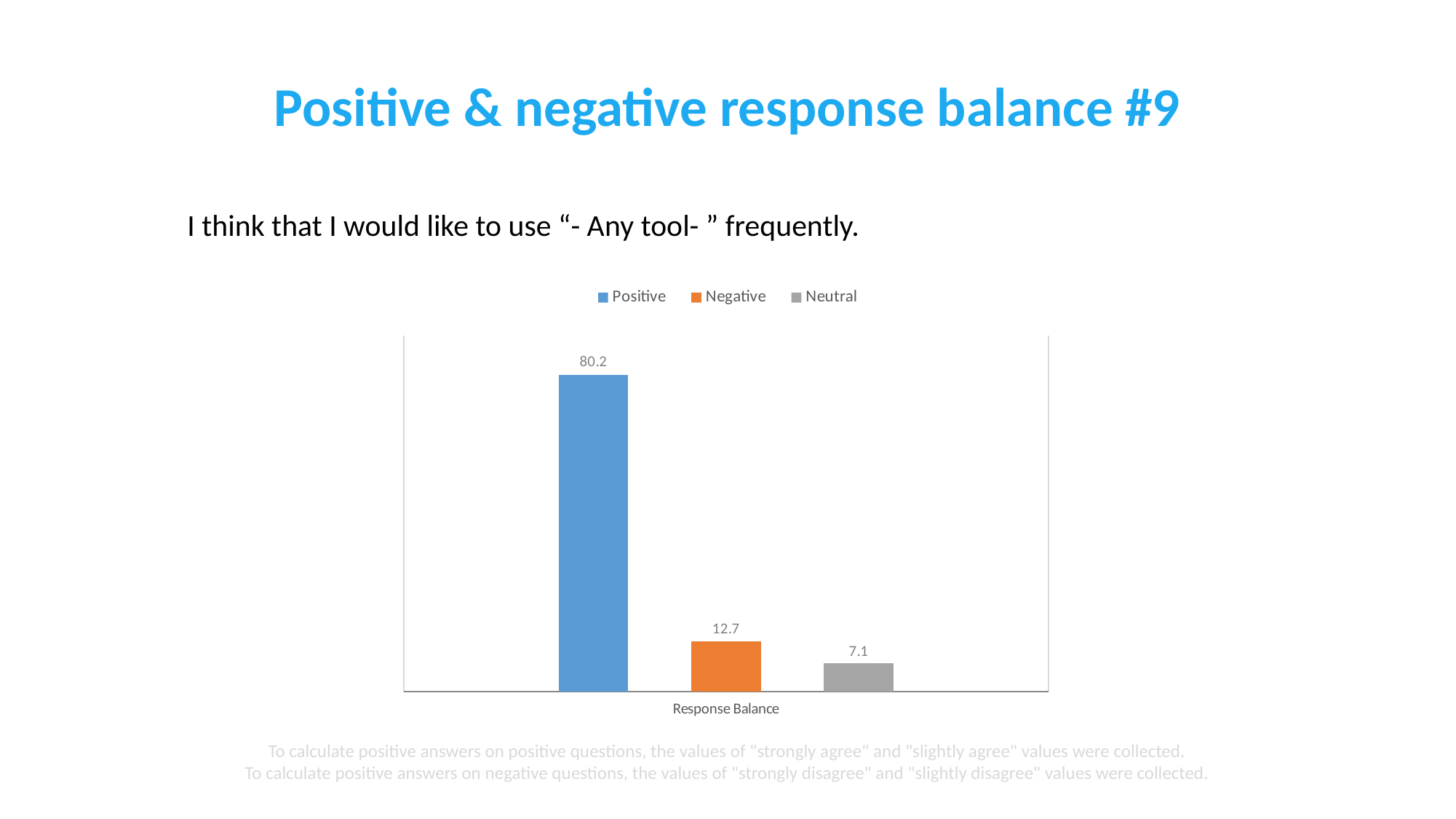
What is the value of the Neutral series? 7.1 What is the value of the Positive series? 80.2 What kind of chart is shown on the slide? Bar chart Which series has the highest value? Positive Which is larger, the Negative value or the Neutral value? Negative What is the value of the Negative series? 12.7 What colour is the Negative bar? Orange What is the difference between the Positive and Negative values? 67.5 How many series does the legend list? 3 What is the label on the x axis of the chart? Response Balance Which series has the lowest value? Neutral What is the difference between the Negative and Neutral values? 5.6